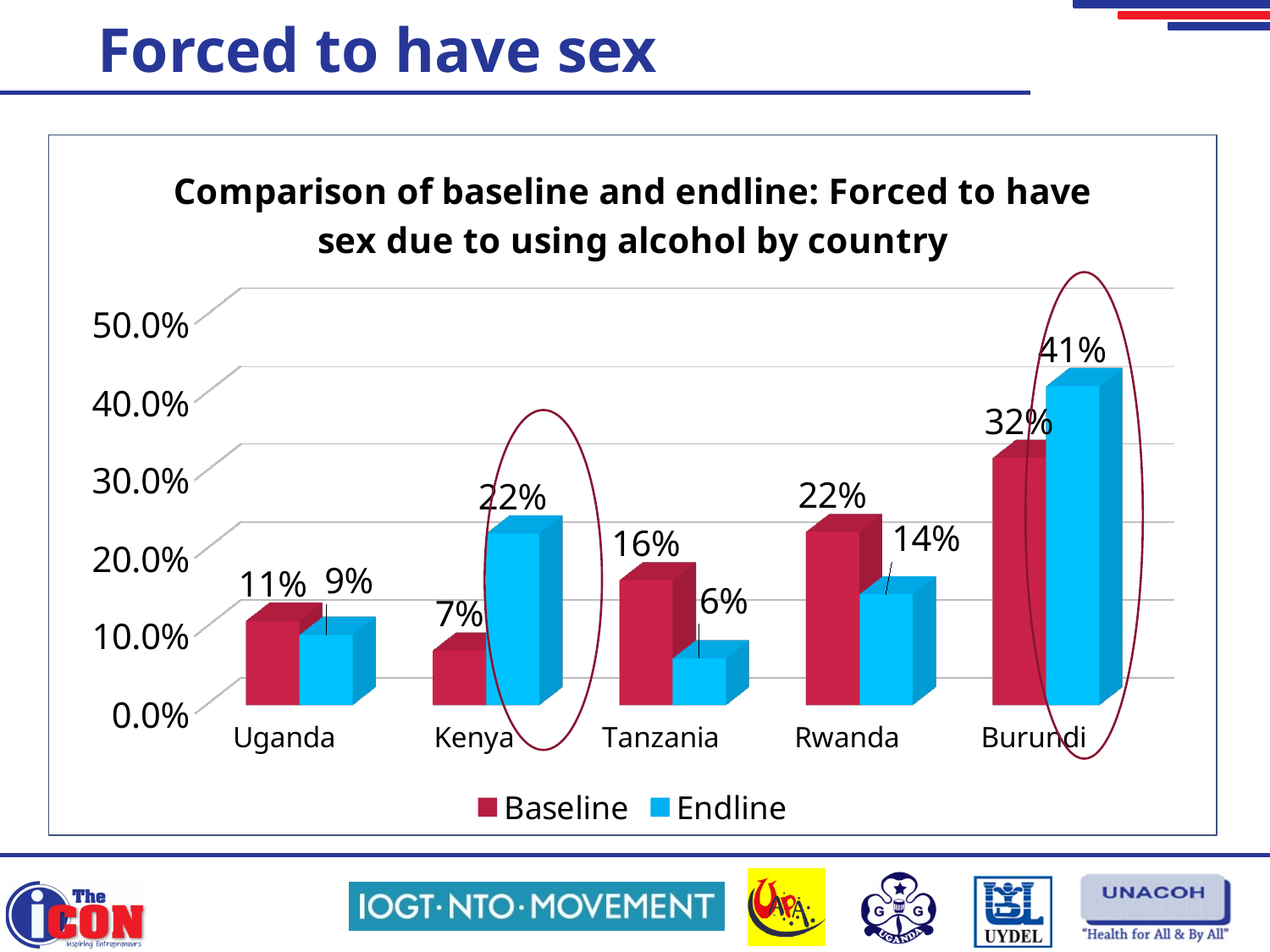
What is the Baseline value for Uganda? 11% What is the Endline value for Tanzania? 6% Which country has the highest Endline value? Burundi What is the Baseline value for Burundi? 32% What kind of chart is shown? Bar chart How many countries are shown on the x axis? 5 Which country has the lowest Baseline value? Kenya Which colour represents the Endline series? Blue What is the Endline value for Kenya? 22% Which is larger for Rwanda, the Baseline or the Endline value? Baseline What is the difference between the Endline and Baseline values for Burundi? 9% How many series does the legend list? 2